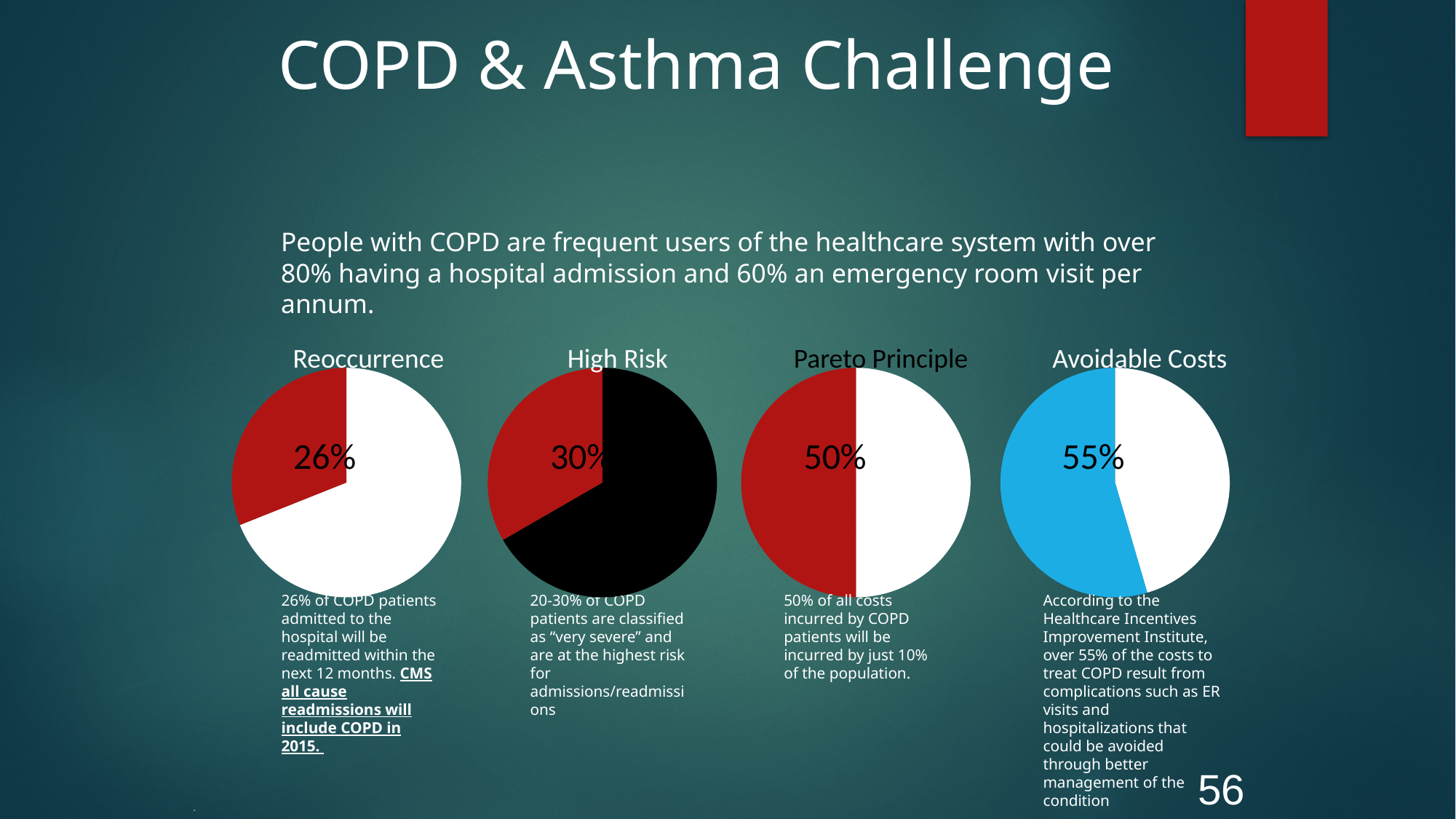
In the "Pareto Principle" pie chart, what percentage is shown for the red slice? 50% What is the difference between the labelled percentage in the "Avoidable Costs" chart and the labelled percentage in the "Reoccurrence" chart? 29% What kind of chart is the "Reoccurrence" chart? Pie chart In the "High Risk" pie chart, what percentage is shown for the red slice? 30% In the "Avoidable Costs" pie chart, what percentage is shown for the blue slice? 55% What colour is the labelled slice in the "Avoidable Costs" pie chart? Blue In the "Reoccurrence" pie chart, what percentage is shown for the red slice? 26% How many slices does the "Pareto Principle" pie chart have? 2 Which of the four pie charts shows the smallest labelled percentage? Reoccurrence How many pie charts are shown on the slide? 4 Which is larger: the labelled percentage in the "High Risk" chart or in the "Pareto Principle" chart? Pareto Principle Which of the four pie charts shows the largest labelled percentage? Avoidable Costs